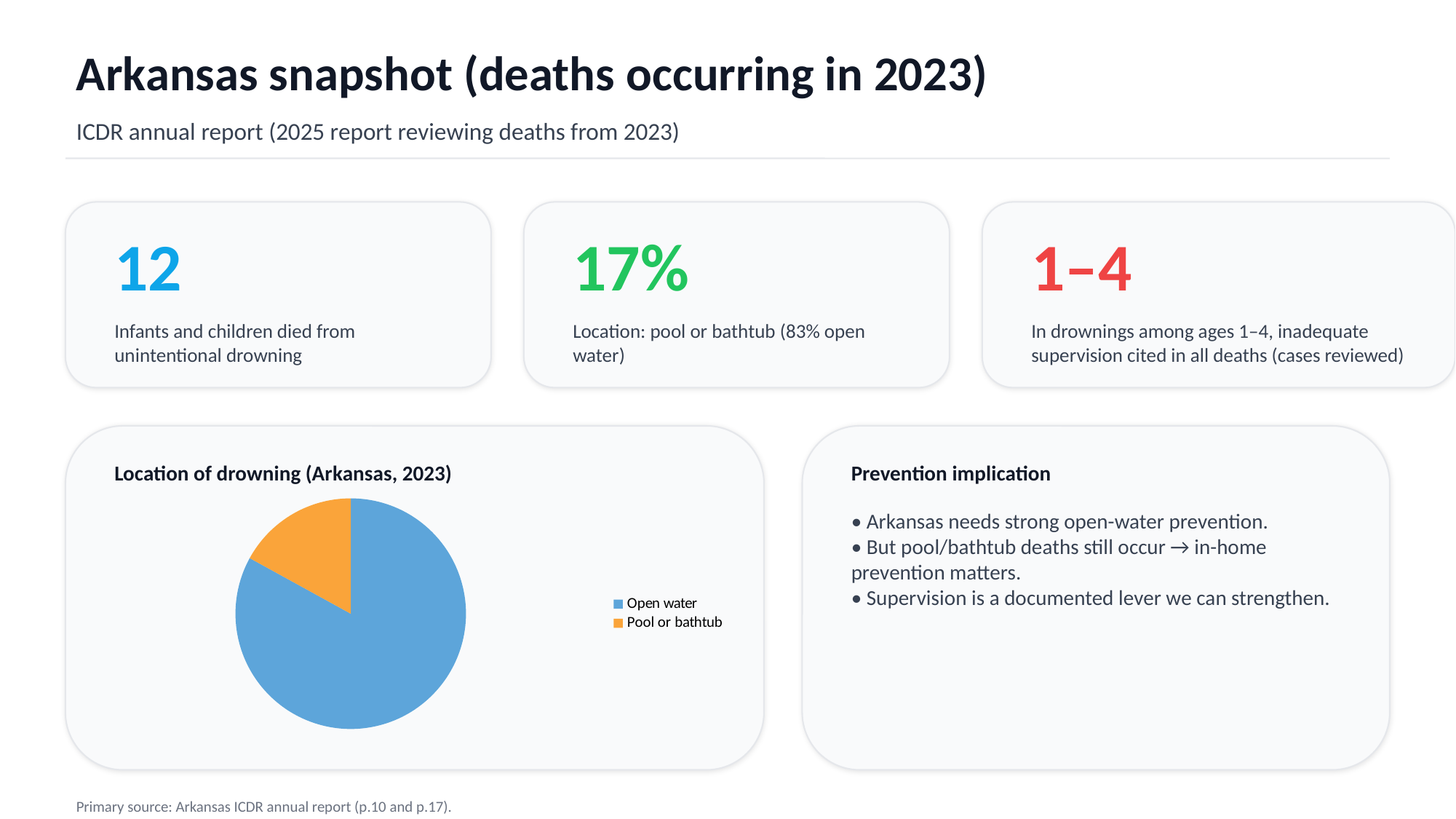
Which category has the largest slice in the "Location of drowning (Arkansas, 2023)" pie chart? Open water According to the slide, what share of drownings in the "Location of drowning (Arkansas, 2023)" chart is Open water? 83% What is the title of the pie chart on the slide? Location of drowning (Arkansas, 2023) What kind of chart is shown under "Location of drowning (Arkansas, 2023)"? Pie chart In the "Location of drowning (Arkansas, 2023)" pie chart, is the Pool or bathtub slice greater or less than 50% of the pie? less How many entries does the legend of the "Location of drowning (Arkansas, 2023)" chart list? 2 In the "Location of drowning (Arkansas, 2023)" pie chart, is the Open water slice greater or less than 50% of the pie? greater In the "Location of drowning (Arkansas, 2023)" pie chart, which is larger: Open water or Pool or bathtub? Open water How many slices does the "Location of drowning (Arkansas, 2023)" pie chart have? 2 Which category has the smallest slice in the "Location of drowning (Arkansas, 2023)" pie chart? Pool or bathtub According to the slide, what share of drownings in the "Location of drowning (Arkansas, 2023)" chart is Pool or bathtub? 17% What colour represents Open water in the "Location of drowning (Arkansas, 2023)" pie chart? Blue